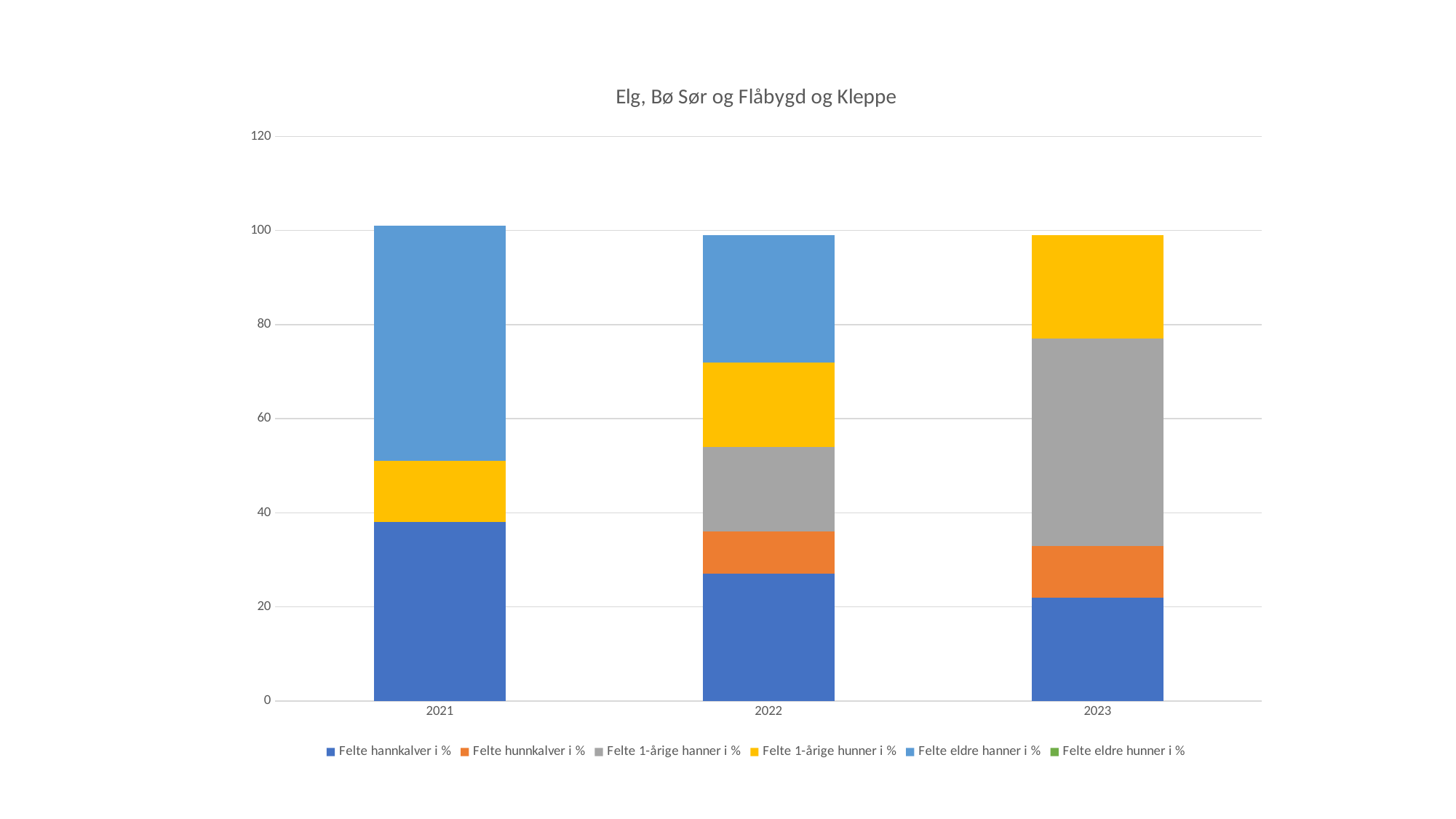
Is the Felte eldre hanner i % segment larger in 2021 or in 2022? 2021 How many series does the chart legend list? 6 Is the value for Felte hannkalver i % in 2021 greater or less than 20? greater Does the Felte hannkalver i % segment rise or fall from 2021 to 2023? Fall Which year has the largest Felte 1-årige hanner i % segment? 2023 Which year has the largest Felte hannkalver i % segment? 2021 Is the total height of the stacked bar for 2021 greater or less than 80? greater Is the value for Felte hannkalver i % in 2023 greater or less than 40? less What is the title of the chart? Elg, Bø Sør og Flåbygd og Kleppe How many years are shown on the x axis of the chart? 3 What kind of chart is shown on the slide? Stacked bar chart Which legend series does not appear as a visible segment in any of the bars? Felte eldre hunner i %